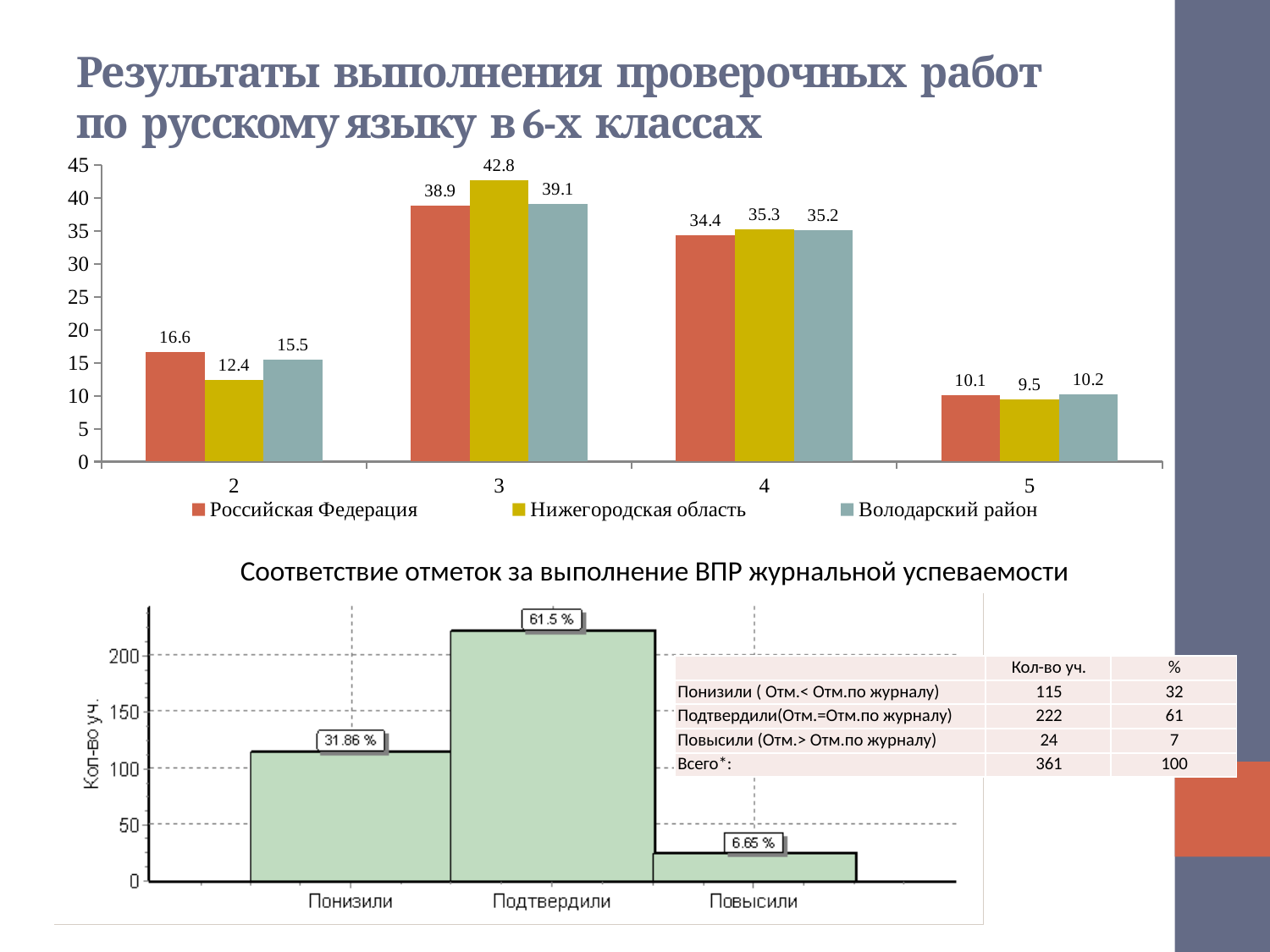
In the top chart, at category 2, which is larger: Российская Федерация or Нижегородская область? Российская Федерация In the top chart, what is the value for Володарский район at category 5? 10.2 In the bottom chart, is the value for Подтвердили greater or less than 200? greater In the top chart, which category has the highest value for Володарский район? 3 In the top chart, what is the difference between the Нижегородская область and Российская Федерация values at category 3? 3.9 In the top chart, what is the value for Российская Федерация at category 2? 16.6 How many series does the legend of the top chart list? 3 In the bottom chart, what percentage label is shown for Подтвердили? 61.5 % In the top chart, what is the value for Нижегородская область at category 3? 42.8 In the top chart, which category has the lowest value for Нижегородская область? 5 In the bottom chart, what percentage label is shown for Повысили? 6.65 % What type of chart is the bottom chart? bar chart